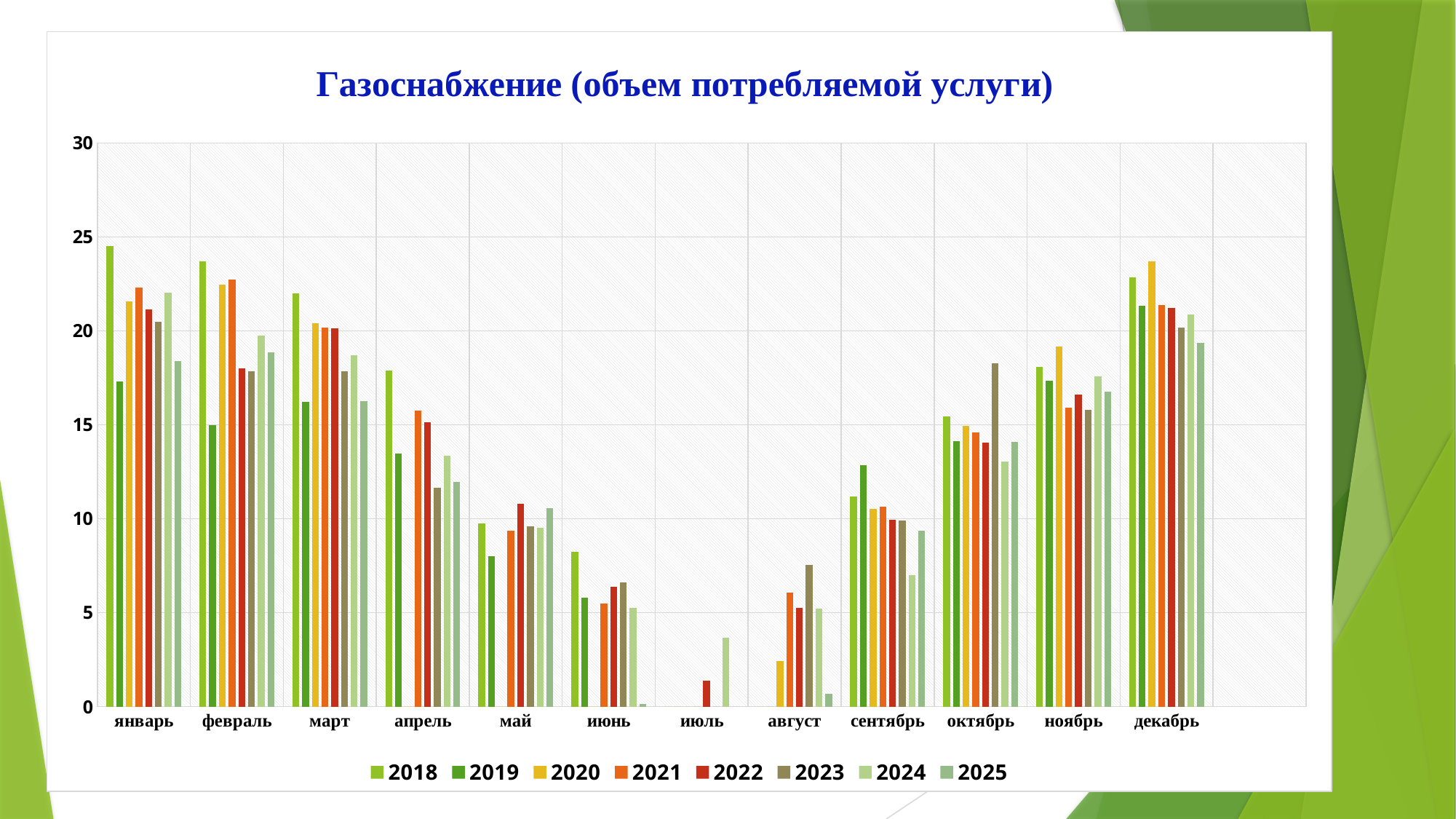
Is the value for 2023 in октябрь greater or less than 15? greater In январь, which year has the highest bar? 2018 Which month has the lowest values overall? июль How many categories (months) are shown on the x axis? 12 What is the title of the chart? Газоснабжение (объем потребляемой услуги) Is the value for 2024 in июль greater or less than 5? less In февраль, which is larger: the value for 2018 or the value for 2019? 2018 In декабрь, which year has the highest bar? 2020 Is the value for 2018 in январь greater or less than 20? greater Do the values for 2018 rise or fall from январь to июнь? fall How many series does the legend list? 8 What kind of chart is shown on the slide? bar chart